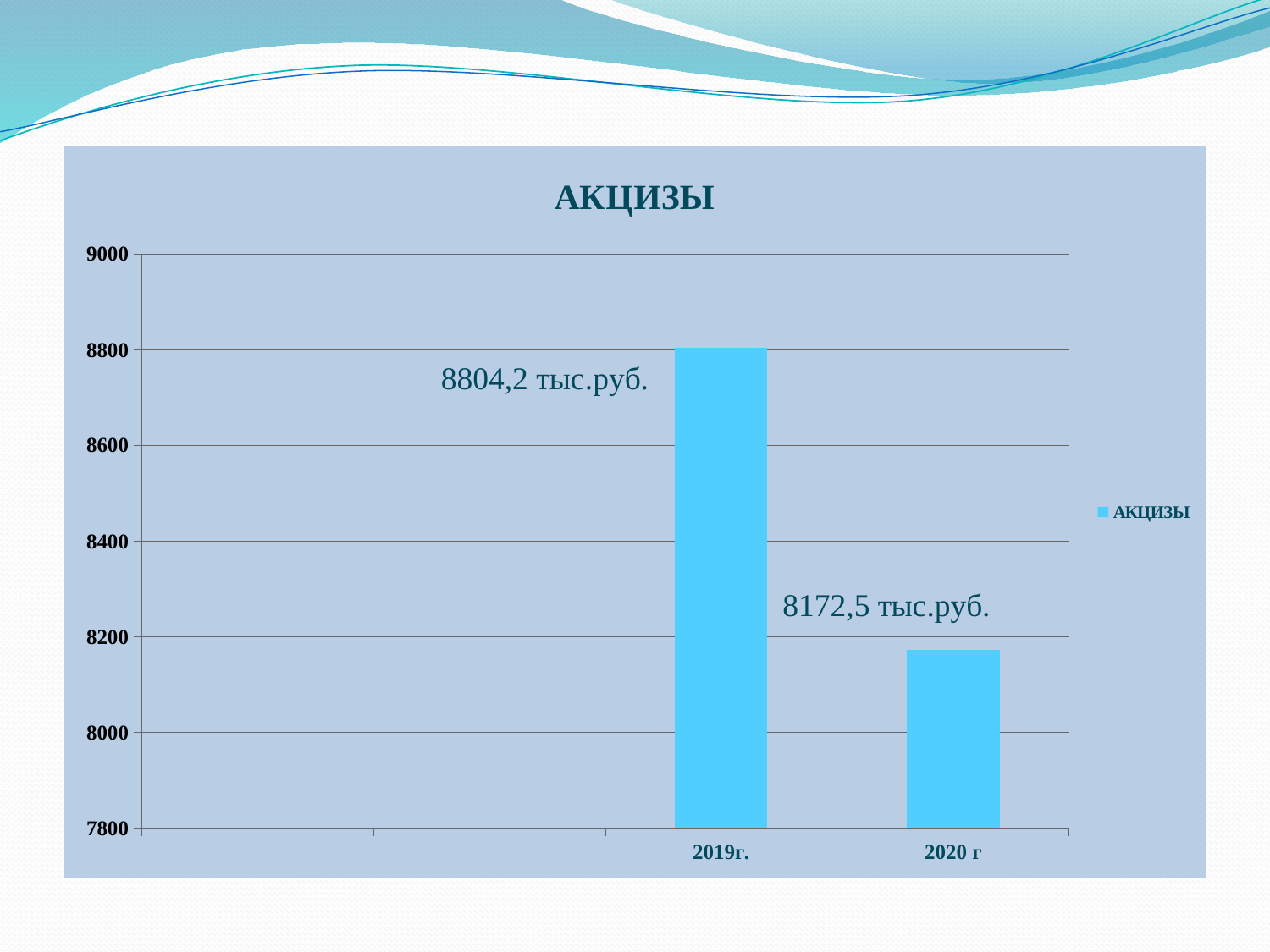
Is the value for 2020 г in the АКЦИЗЫ chart greater or less than 8400? less Do the values in the АКЦИЗЫ chart rise or fall from 2019г. to 2020 г? Fall How many series does the legend of the АКЦИЗЫ chart list? 1 Which is larger in the АКЦИЗЫ chart, the value for 2019г. or for 2020 г? 2019г. What is the value for 2020 г in the АКЦИЗЫ chart? 8172,5 тыс.руб. Which year has the highest value in the АКЦИЗЫ chart? 2019г. What is the difference between the 2019г. and 2020 г values in the АКЦИЗЫ chart? 631,7 тыс.руб. Is the value for 2019г. in the АКЦИЗЫ chart greater or less than 8600? greater How many bars are shown in the АКЦИЗЫ chart? 2 What is the value for 2019г. in the АКЦИЗЫ chart? 8804,2 тыс.руб. Which year has the lowest value in the АКЦИЗЫ chart? 2020 г What type of chart is shown on the slide? Bar chart